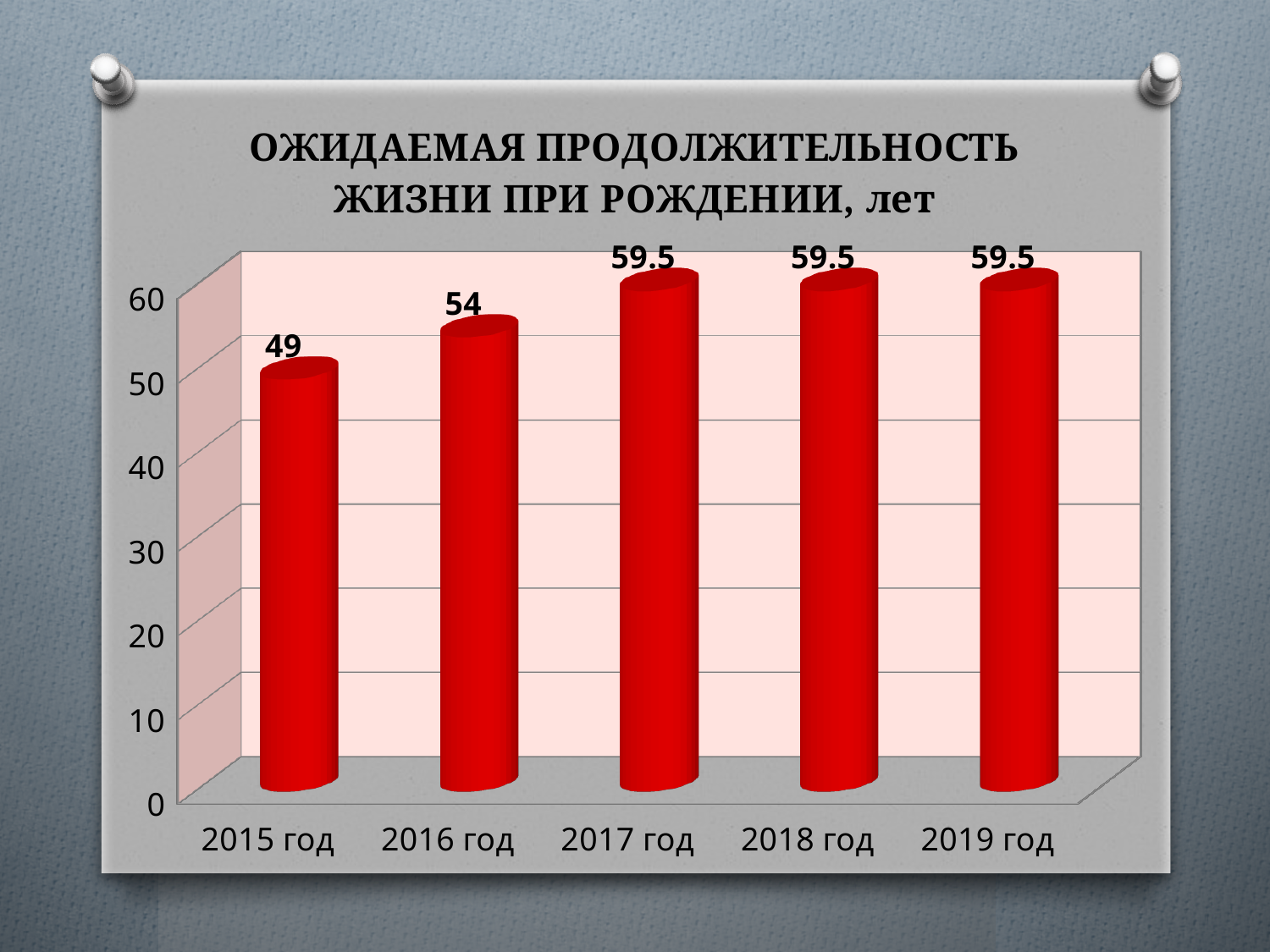
What is the difference between the values for 2017 год and 2016 год? 5.5 Is the value for 2015 год greater or less than 50? less What is the value for 2016 год? 54 What is the value for 2019 год? 59.5 What is the value for 2015 год? 49 Do the values rise or fall from 2015 год to 2017 год? rise Which is larger, the value for 2016 год or the value for 2018 год? 2018 год Which year has the lowest value? 2015 год How many years are shown on the x axis? 5 What kind of chart is shown on the slide? bar chart What is the difference between the values for 2016 год and 2015 год? 5 What is the value for 2017 год? 59.5